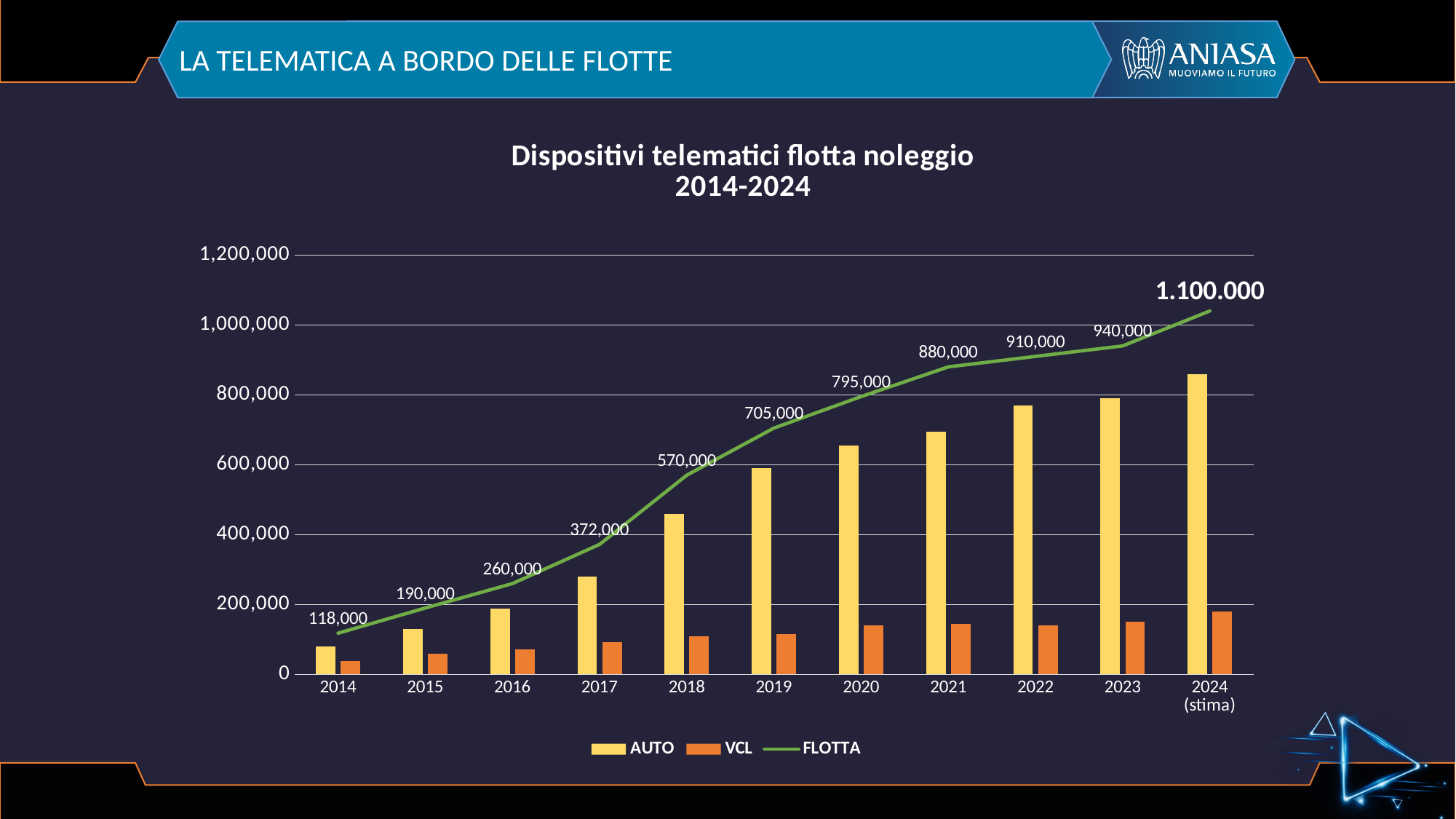
What is the difference between the FLOTTA values for 2019 and 2017? 333,000 Is the VCL value for 2014 greater or less than 100,000? less What is the FLOTTA value for 2024 (stima)? 1.100.000 Does the FLOTTA line rise or fall from 2014 to 2024? rise How many years are shown on the x axis? 11 Is the AUTO value for 2024 (stima) greater or less than 800,000? greater What is the FLOTTA value for 2021? 880,000 What is the difference between the FLOTTA values for 2023 and 2022? 30,000 In which year is the FLOTTA value lowest? 2014 What is the FLOTTA value for 2018? 570,000 How many series does the legend list? 3 What is the FLOTTA value for 2014? 118,000